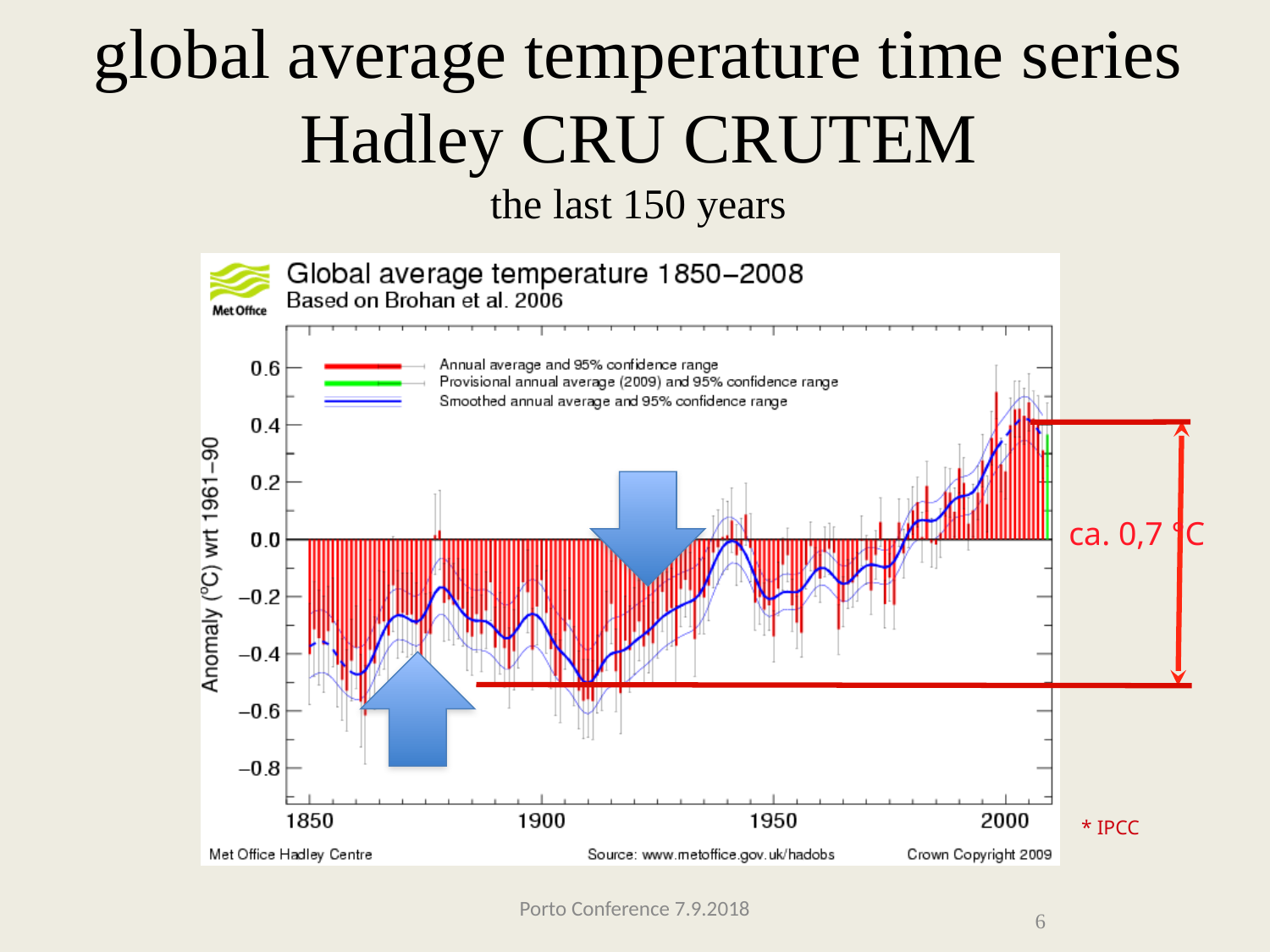
Overall, do the temperature anomaly values rise or fall from 1850 to 2008? rise Which is larger, the smoothed annual average around 2000 or the smoothed annual average around 1910? around 2000 What kind of chart is shown on the slide? bar chart What is the label of the y axis? Anomaly (°C) wrt 1961–90 Is the smoothed annual average around 1940 greater or less than -0.2? greater What is the title of the chart? Global average temperature 1850–2008 According to the red annotation, what is the approximate temperature rise marked between the low and high levels on the chart? ca. 0,7 °C Is the annual average temperature anomaly around 2000 greater or less than 0.2? greater What is the highest value shown on the y axis? 0.6 How many entries does the chart legend list? 3 Is the smoothed annual average around 1910 greater or less than -0.4? less